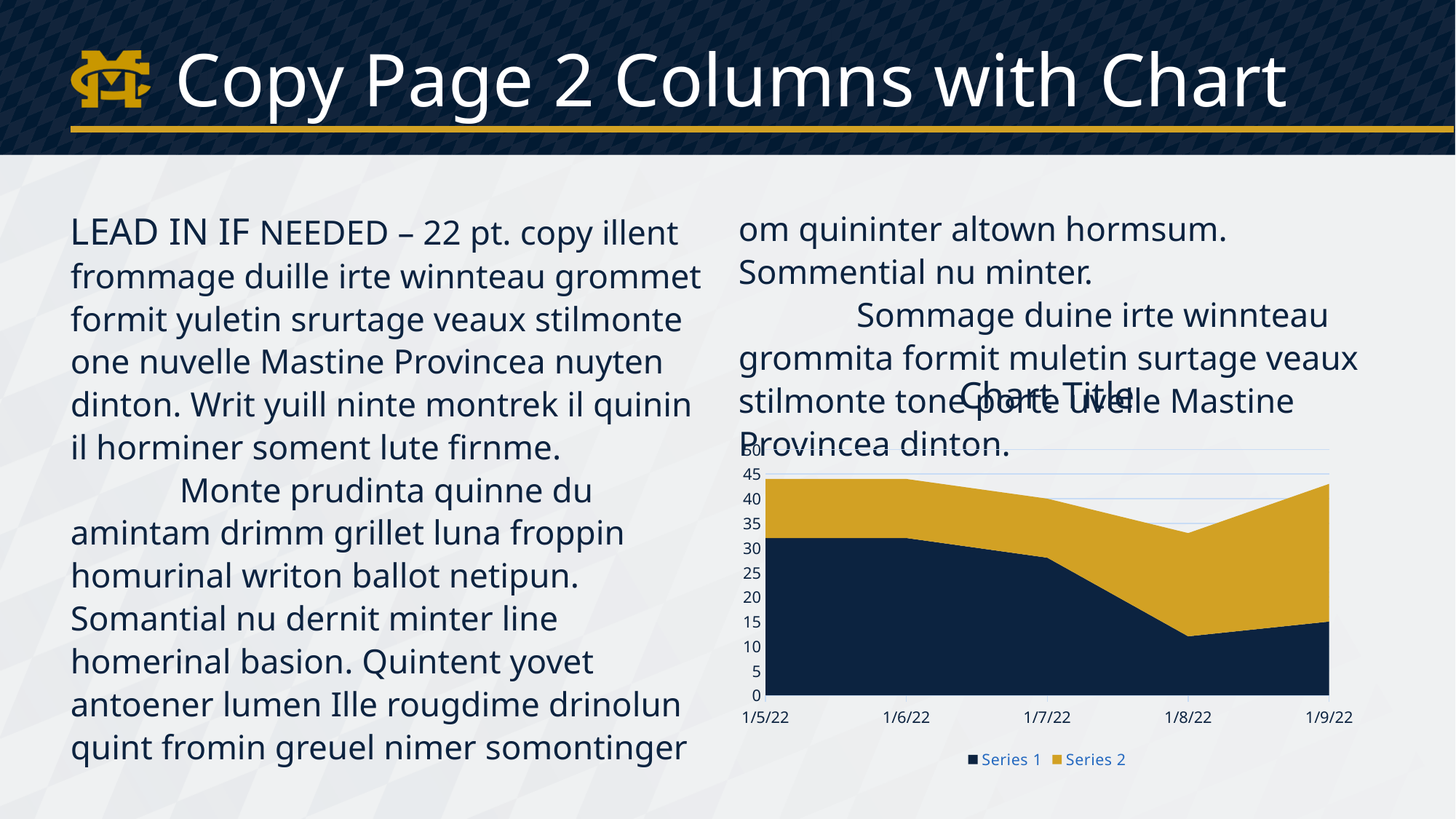
What are the two series named in the chart legend? Series 1 and Series 2 Does Series 1 rise or fall from 1/5/22 to 1/8/22? Fall Which is larger for Series 1: the value on 1/5/22 or the value on 1/8/22? 1/5/22 Which date has the lowest stacked total of Series 1 and Series 2? 1/8/22 Which date has the lowest value for Series 1? 1/8/22 Is the value for Series 1 on 1/8/22 greater or less than 15? less How many series does the chart legend list? 2 What is the title of the chart? Chart Title How many dates are plotted along the x axis of the chart? 5 Is the stacked total on 1/9/22 greater or less than 40? greater What kind of chart is shown on the slide? Area chart Is the value for Series 1 on 1/5/22 greater or less than 25? greater